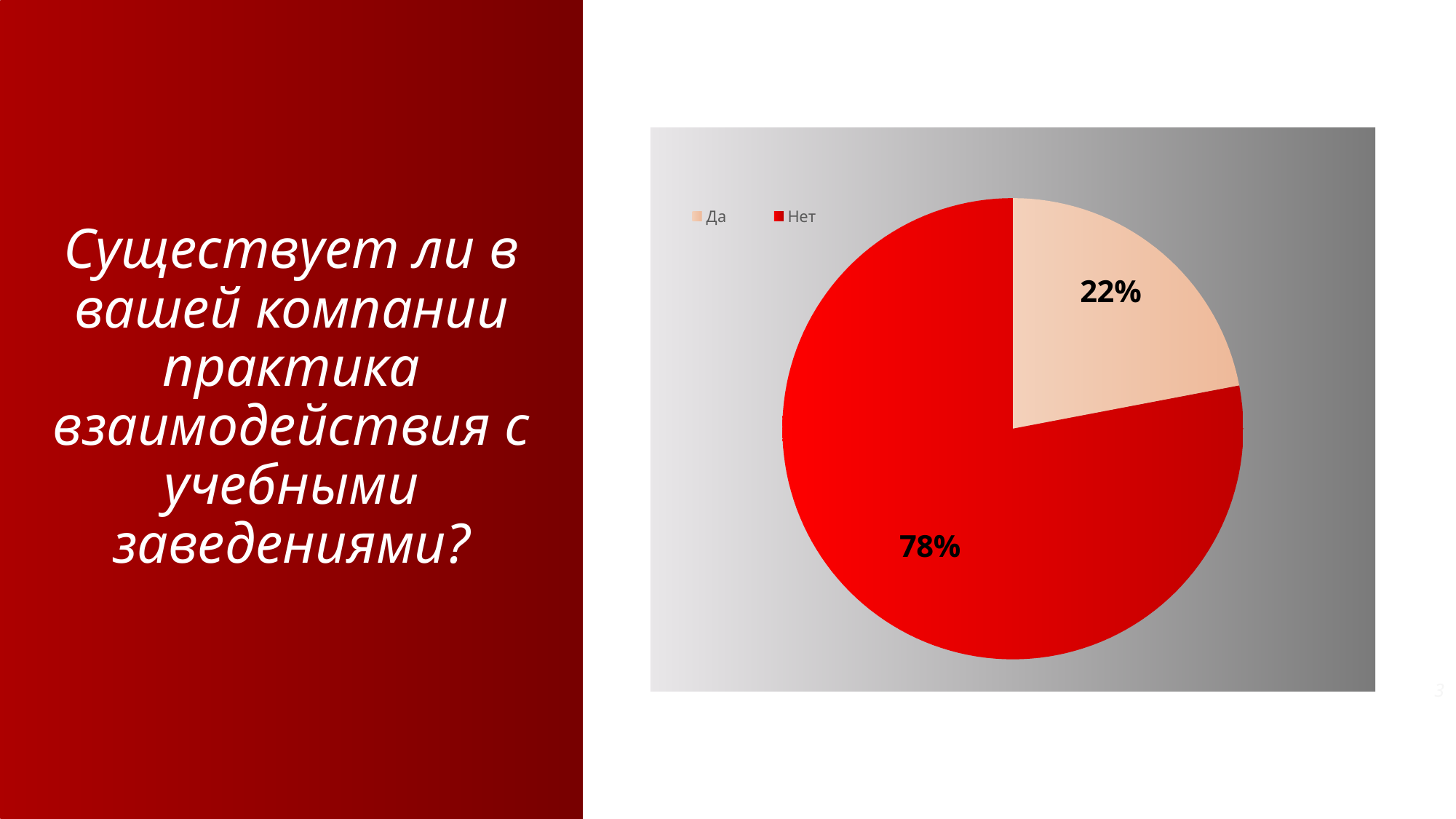
What is the difference in percentage points between the "Нет" and "Да" slices? 56 How many entries does the legend list? 2 What are the two legend entries of the pie chart? Да, Нет What share of the pie does the "Да" slice represent? 22% Which is larger, the "Да" slice or the "Нет" slice? Нет What colour is the "Нет" slice? red Which slice of the pie is the smallest? Да What share of the pie does the "Нет" slice represent? 78% How many slices does the pie chart have? 2 What kind of chart is shown on the slide? pie chart Which slice of the pie is the largest? Нет